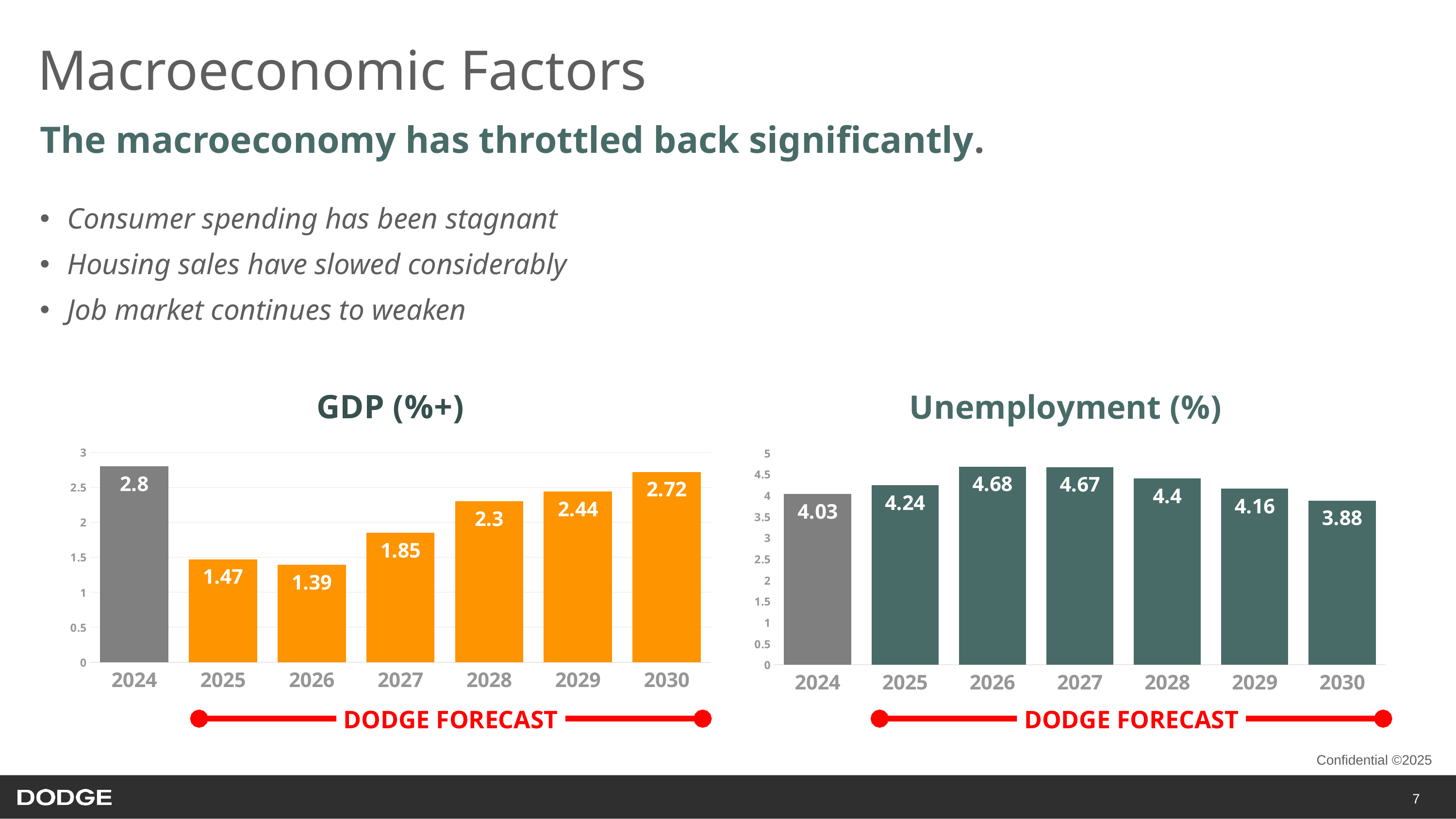
In the GDP (%+) chart, which year has the lowest value? 2026 In the Unemployment (%) chart, which year has the lowest value? 2030 How many years are shown in the Unemployment (%) chart? 7 What kind of chart is the GDP (%+) chart? bar chart In the Unemployment (%) chart, which is larger, the value for 2025 or the value for 2029? 2025 In the GDP (%+) chart, do the values rise or fall from 2026 to 2030? rise In the GDP (%+) chart, is the value for 2028 greater or less than 2? greater In the Unemployment (%) chart, what is the difference between the values for 2026 and 2024? 0.65 In the GDP (%+) chart, what is the difference between the values for 2030 and 2025? 1.25 In the GDP (%+) chart, what is the value for 2026? 1.39 In the Unemployment (%) chart, what is the value for 2027? 4.67 In the GDP (%+) chart, which year has the highest value? 2024